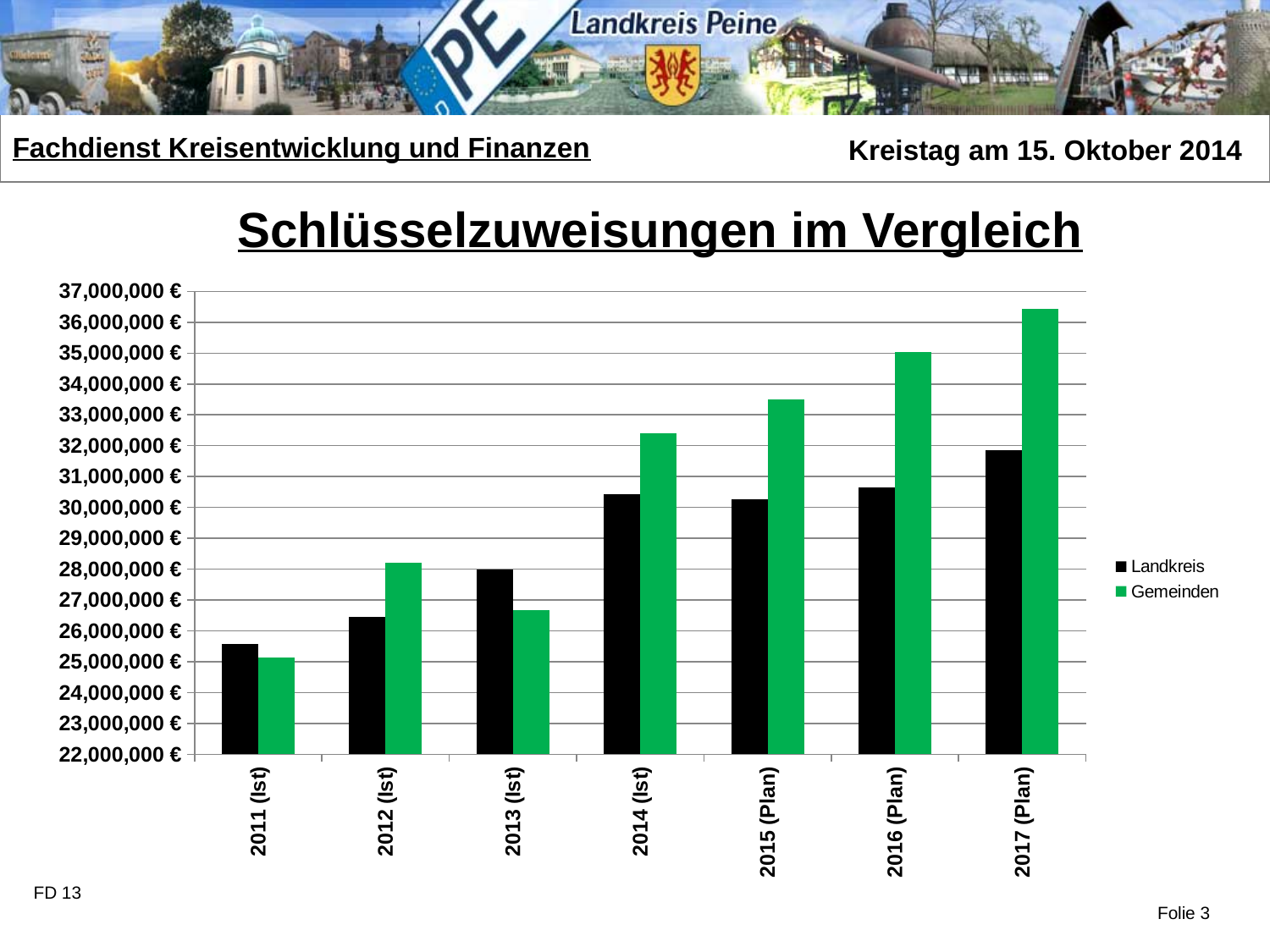
In which year is the Gemeinden value highest? 2017 (Plan) How many series does the legend list? 2 In which year is the Landkreis value highest? 2017 (Plan) In which year is the Landkreis value lowest? 2011 (Ist) How many year categories are shown on the x axis? 7 What kind of chart is shown on the slide? bar chart For 2013 (Ist), which is larger, Landkreis or Gemeinden? Landkreis In which year is the Gemeinden value lowest? 2011 (Ist) Is the Gemeinden value for 2017 (Plan) greater or less than 36,000,000 €? greater For 2016 (Plan), which is larger, Landkreis or Gemeinden? Gemeinden What is the title of the chart? Schlüsselzuweisungen im Vergleich Is the Gemeinden value for 2011 (Ist) greater or less than 26,000,000 €? less